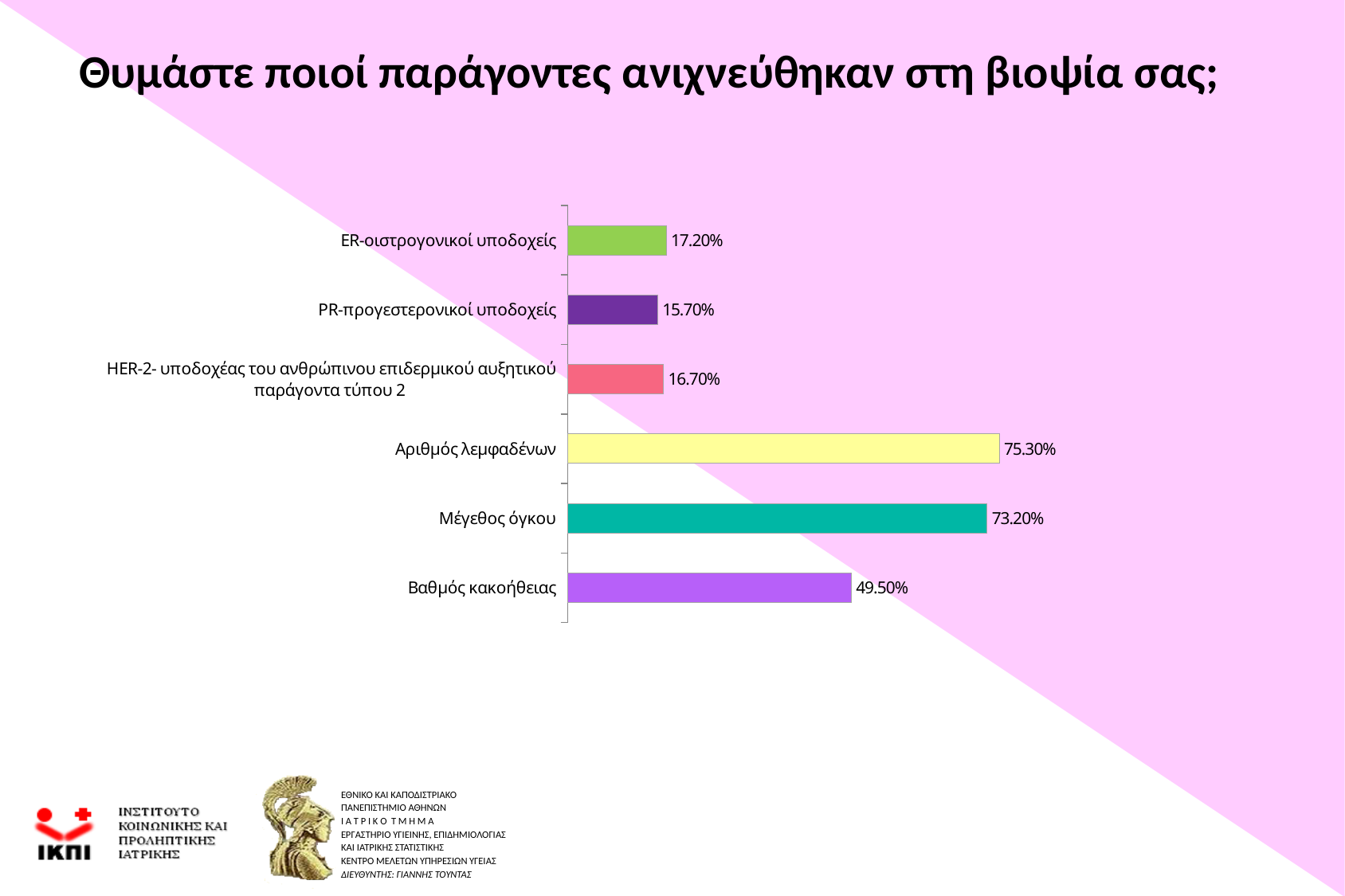
Which category has the highest value? Αριθμός λεμφαδένων What is the difference between the values for ER-οιστρογονικοί υποδοχείς and PR-προγεστερονικοί υποδοχείς? 1.50% Which category has the lowest value? PR-προγεστερονικοί υποδοχείς What is the value for ER-οιστρογονικοί υποδοχείς? 17.20% What is the value for HER-2- υποδοχέας του ανθρώπινου επιδερμικού αυξητικού παράγοντα τύπου 2? 16.70% What colour is the bar for Μέγεθος όγκου? Teal What is the value for Βαθμός κακοήθειας? 49.50% What is the value for Αριθμός λεμφαδένων? 75.30% What is the difference between the values for Αριθμός λεμφαδένων and Μέγεθος όγκου? 2.10% What kind of chart is shown on the slide? Bar chart How many categories are shown in the chart? 6 Which is larger, the value for Μέγεθος όγκου or the value for Βαθμός κακοήθειας? Μέγεθος όγκου